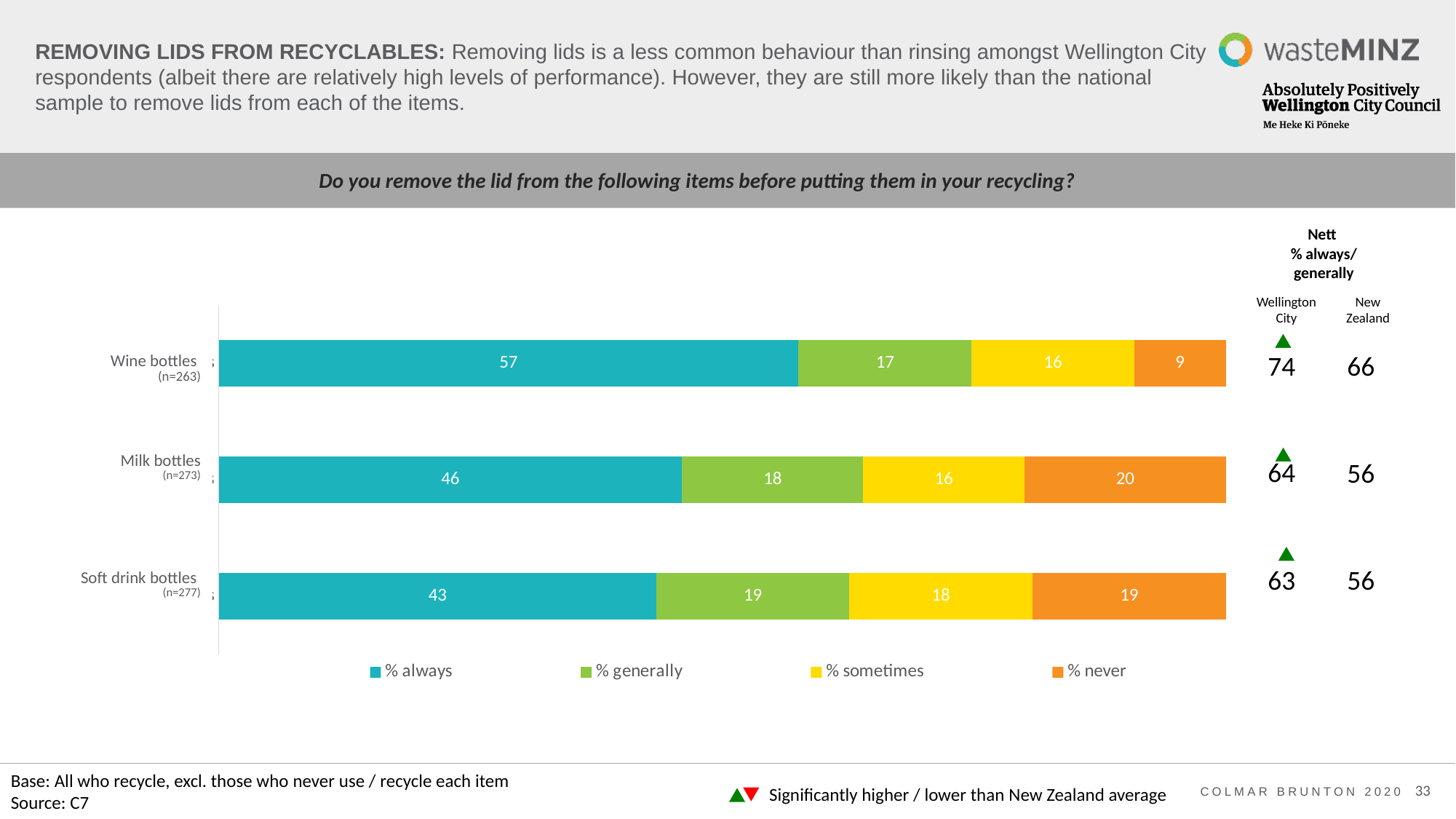
What is the Nett % always/generally value for Wellington City for milk bottles? 64 What is the difference between the '% always' values for wine bottles and soft drink bottles? 14 Is the '% sometimes' value larger for soft drink bottles or for milk bottles? Soft drink bottles What colour represents '% never' in the chart? Orange What percentage of respondents say they never remove the lid from milk bottles? 20 Which item has the highest '% always' value? Wine bottles What kind of chart is shown on the slide? Stacked bar chart What percentage of respondents say they always remove the lid from wine bottles? 57 How many series does the legend list? 4 How many items (categories) are shown in the chart? 3 What percentage of respondents say they generally remove the lid from soft drink bottles? 19 Which item has the lowest '% never' value? Wine bottles